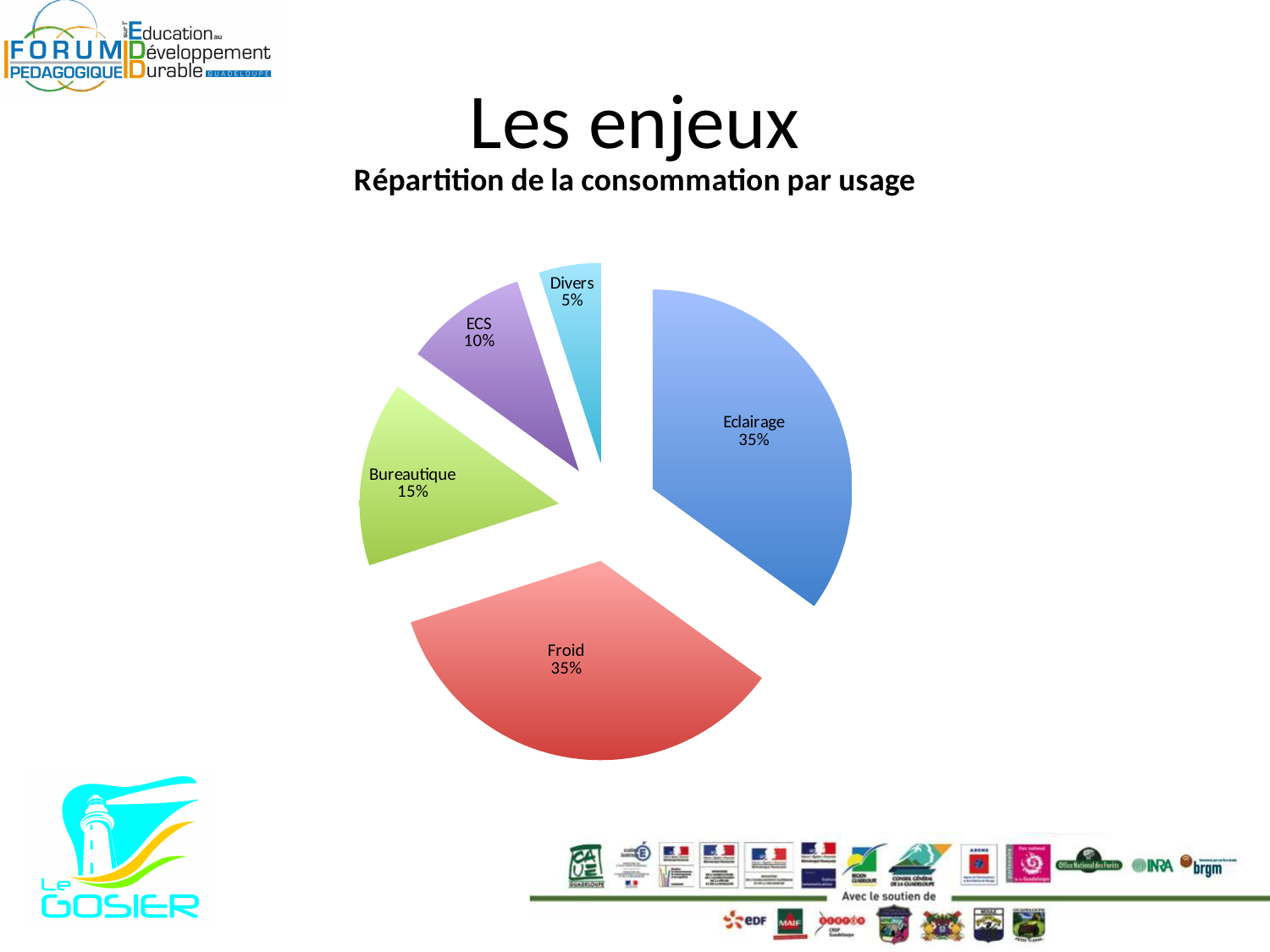
What share of the pie does Froid represent? 35% Which is larger, the share for Bureautique or the share for ECS? Bureautique Which usage has the smallest share of consumption? Divers What kind of chart is shown on the slide? Pie chart What is the difference between the shares of ECS and Divers? 5% What share of consumption does Eclairage account for? 35% What percentage is shown for Bureautique? 15% What is the title of the chart? Répartition de la consommation par usage What is the difference between the shares of Eclairage and Bureautique? 20% How many slices does the pie chart have? 5 What is the value for ECS? 10% Which is larger, the share for Froid or the share for Divers? Froid